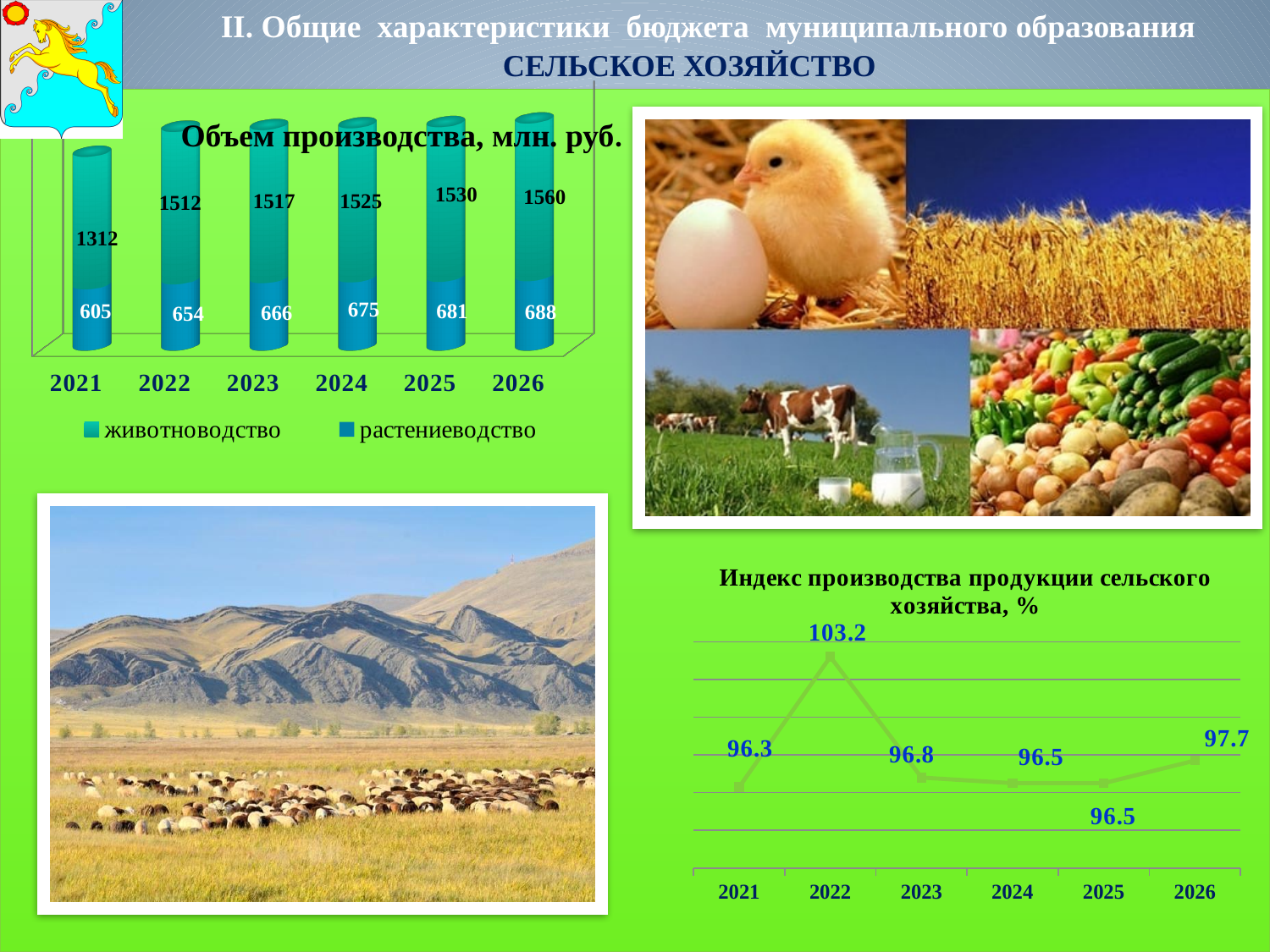
In the chart 'Индекс производства продукции сельского хозяйства, %', which year has the lowest value? 2021 In the chart 'Объем производства, млн. руб.', what is the total of the stacked bar for 2021? 1917 In the chart 'Объем производства, млн. руб.', what is the difference between the животноводство values for 2026 and 2021? 248 In the chart 'Объем производства, млн. руб.', what is the value for растениеводство in 2024? 675 In the chart 'Объем производства, млн. руб.', how many series does the legend list? 2 What kind of chart is 'Индекс производства продукции сельского хозяйства, %'? line chart In the chart 'Индекс производства продукции сельского хозяйства, %', what is the value for 2022? 103.2 In the chart 'Объем производства, млн. руб.', do the растениеводство values rise or fall from 2021 to 2026? rise In the chart 'Объем производства, млн. руб.', what is the value for животноводство in 2021? 1312 In the chart 'Объем производства, млн. руб.', which year has the highest value for животноводство? 2026 In the chart 'Индекс производства продукции сельского хозяйства, %', which is larger, the value for 2023 or the value for 2026? 2026 In the chart 'Объем производства, млн. руб.', which year has the lowest value for растениеводство? 2021